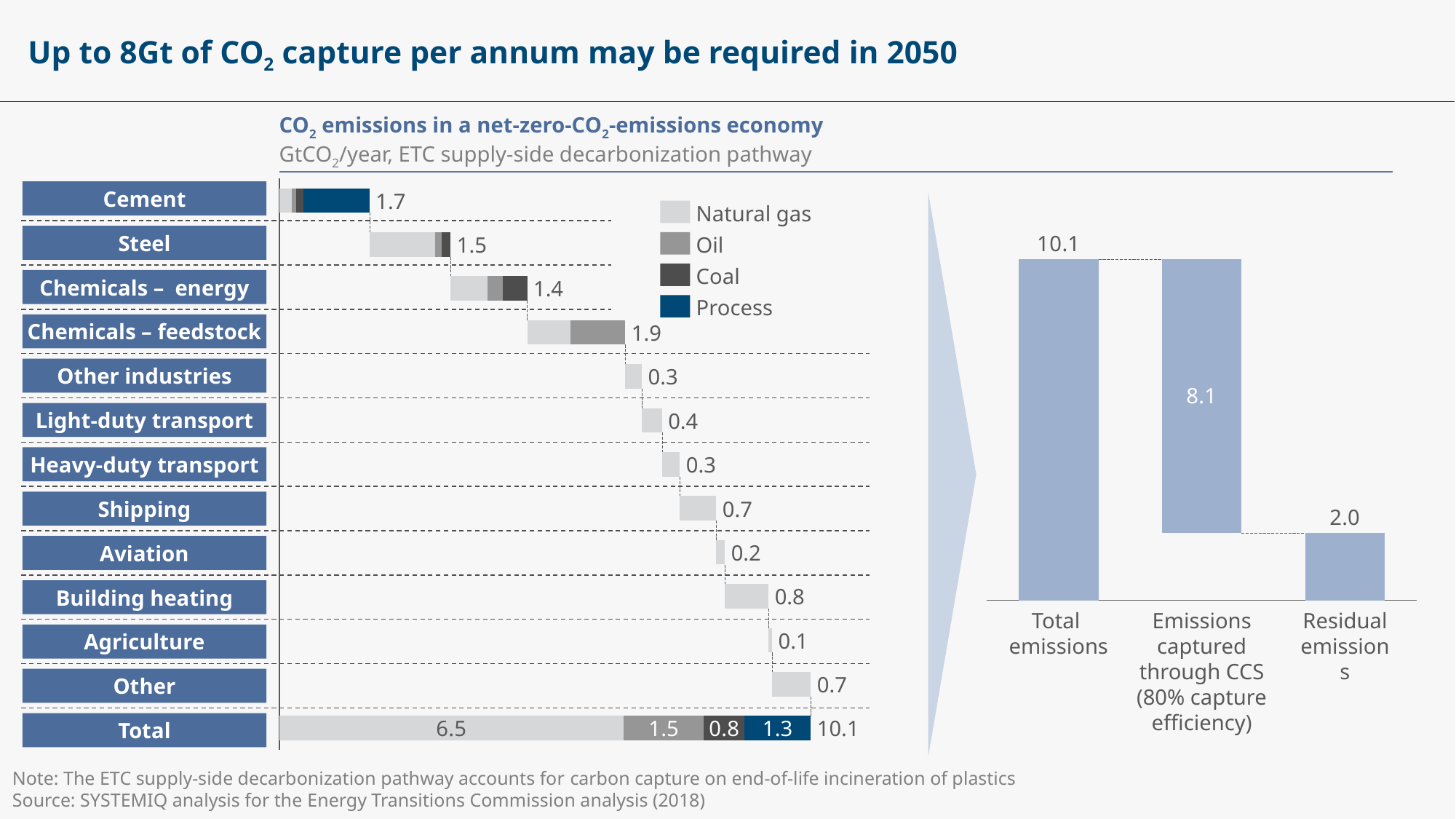
In the left waterfall chart, which sector has the lowest emissions value? Agriculture What kind of chart is the chart on the right of the slide? Bar chart In the left waterfall chart, which sector has the highest emissions value? Chemicals – feedstock In the Total bar of the left chart, what is the value of the Natural gas segment? 6.5 In the right bar chart, what is the value for Emissions captured through CCS? 8.1 In the left waterfall chart, how many sectors are listed, excluding the Total row? 12 In the left waterfall chart, which is larger, the value for Steel or the value for Chemicals – energy? Steel In the left waterfall chart, what is the value for Chemicals – feedstock? 1.9 How many series does the legend of the left waterfall chart list? 4 In the left waterfall chart, what is the CO2 emissions value for Cement? 1.7 In the left waterfall chart, what is the difference between the values for Building heating and Aviation? 0.6 What is the total value shown for the Total bar in the left chart? 10.1